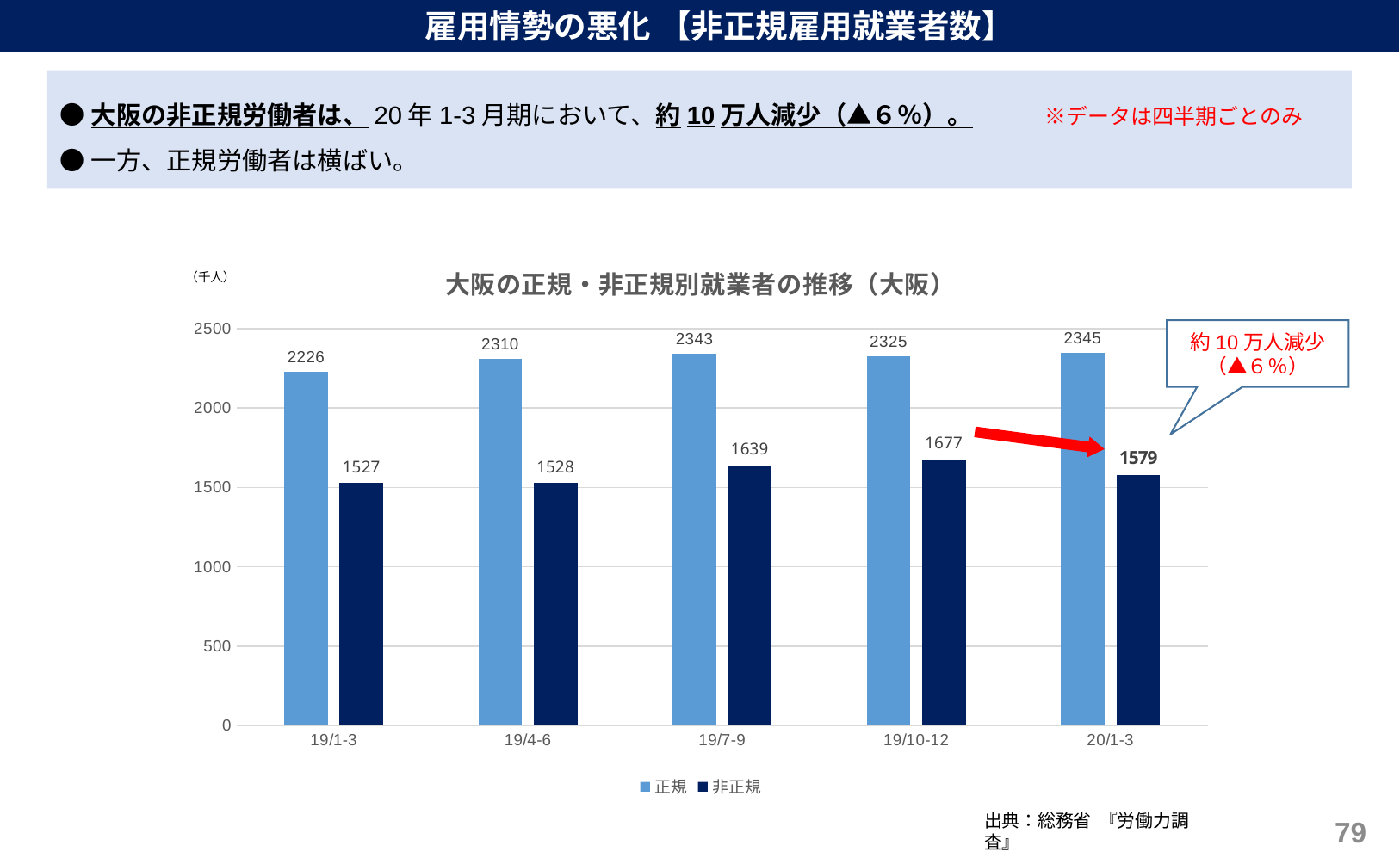
What is the value for 非正規 in 20/1-3? 1579 Which period has the highest value for 正規? 20/1-3 How many series does the legend list? 2 Is the value for 非正規 in 19/7-9 greater or less than 2000? less Which period has the lowest value for 非正規? 19/1-3 What is the title of the chart? 大阪の正規・非正規別就業者の推移（大阪） How many periods are shown on the x axis? 5 What is the difference between the 非正規 values for 19/10-12 and 20/1-3? 98 Which is larger, the 正規 value in 19/7-9 or in 19/10-12? 19/7-9 What kind of chart is shown on the slide? bar chart What is the value for 正規 in 19/1-3? 2226 What is the value for 非正規 in 19/10-12? 1677